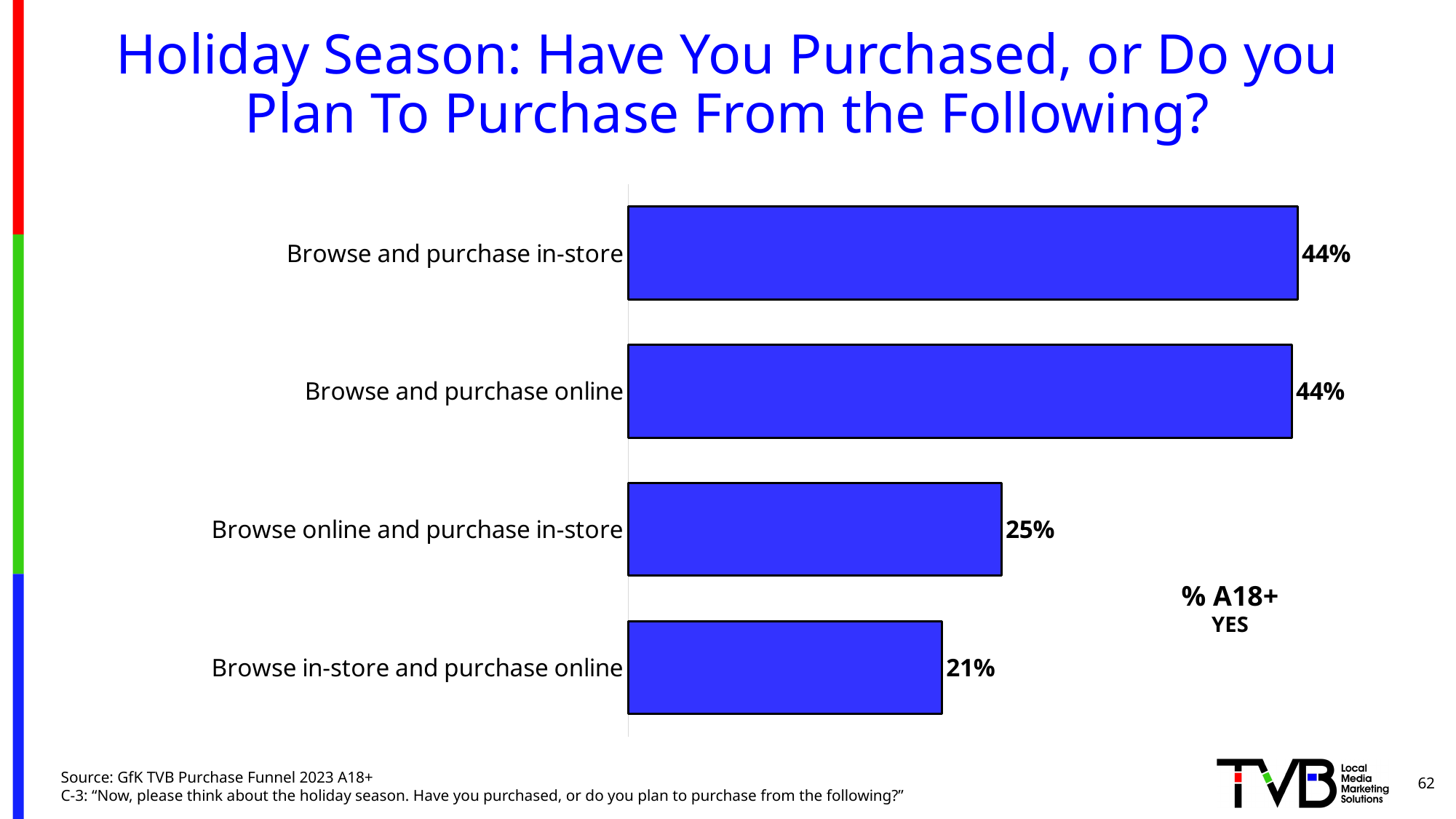
What is the difference between 'Browse and purchase in-store' and 'Browse in-store and purchase online'? 23% What is the value for 'Browse online and purchase in-store'? 25% What percentage of adults 18+ said yes to 'Browse and purchase in-store'? 44% Which is larger: 'Browse and purchase online' or 'Browse online and purchase in-store'? Browse and purchase online What is the difference between 'Browse online and purchase in-store' and 'Browse in-store and purchase online'? 4% What percentage of adults 18+ said yes to 'Browse and purchase online'? 44% What is the value for 'Browse in-store and purchase online'? 21% Which category has the lowest value? Browse in-store and purchase online Which is larger: 'Browse online and purchase in-store' or 'Browse in-store and purchase online'? Browse online and purchase in-store What kind of chart is shown on the slide? Bar chart What is the source cited for the chart data? GfK TVB Purchase Funnel 2023 A18+ How many categories are shown in the chart? 4